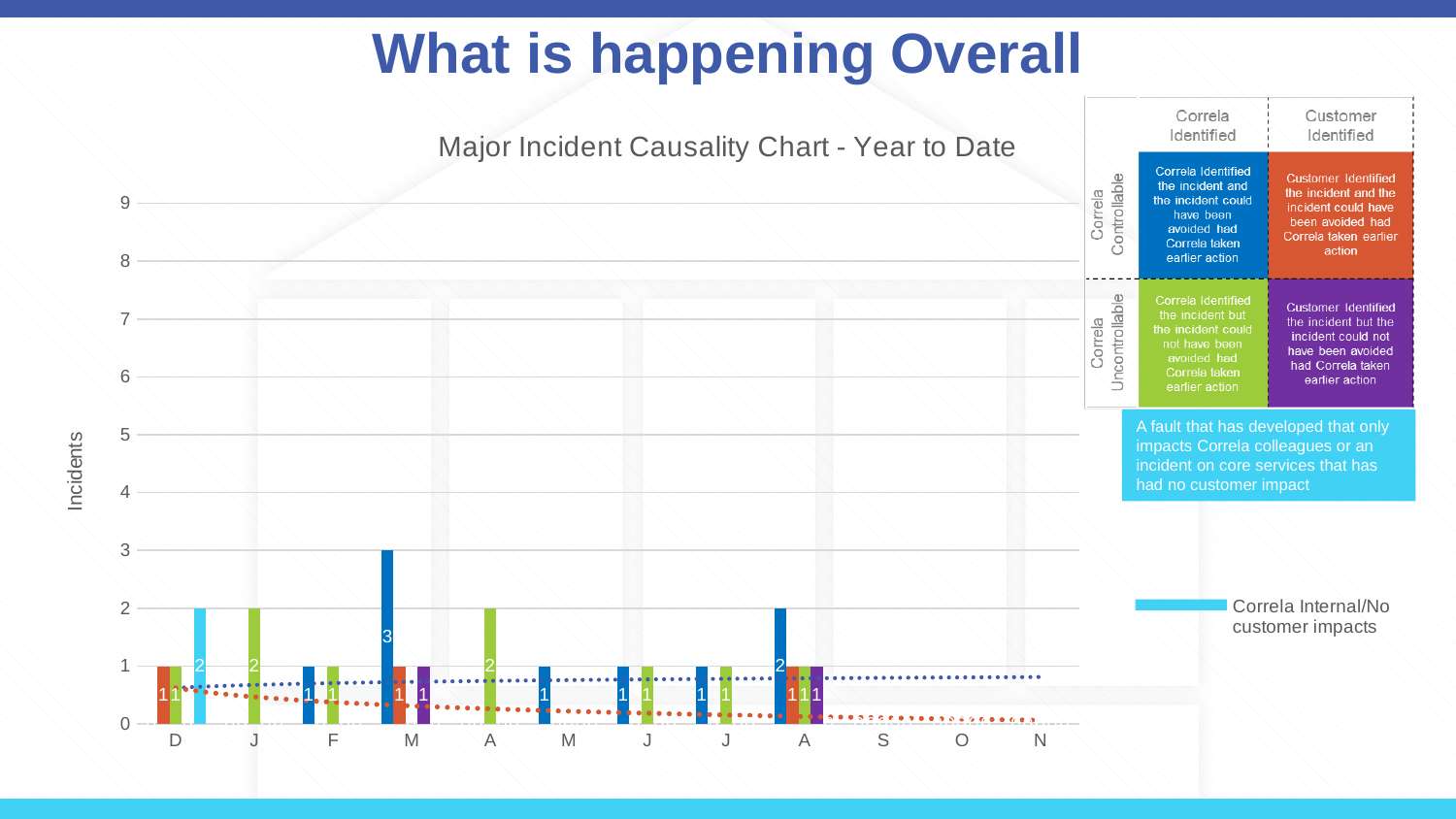
What is the difference between the dark blue bar in March (3) and the dark blue bar in August (2)? 1 What is the value of the green bar in the first J month? 2 What is the highest value of any bar in the chart? 3 Is the highest bar in the chart greater or less than 5 incidents? less What is the label on the vertical axis of the chart? Incidents What is the value of the light blue bar in the first month (D)? 2 What is the title of the chart on the slide? Major Incident Causality Chart - Year to Date What is the value of the dark blue bar in the second A month (August)? 2 What kind of chart is the Major Incident Causality Chart? bar chart Which is larger: the dark blue bar in the first M month (March) or the dark blue bar in the second A month (August)? March How many month categories are shown along the x axis of the chart? 12